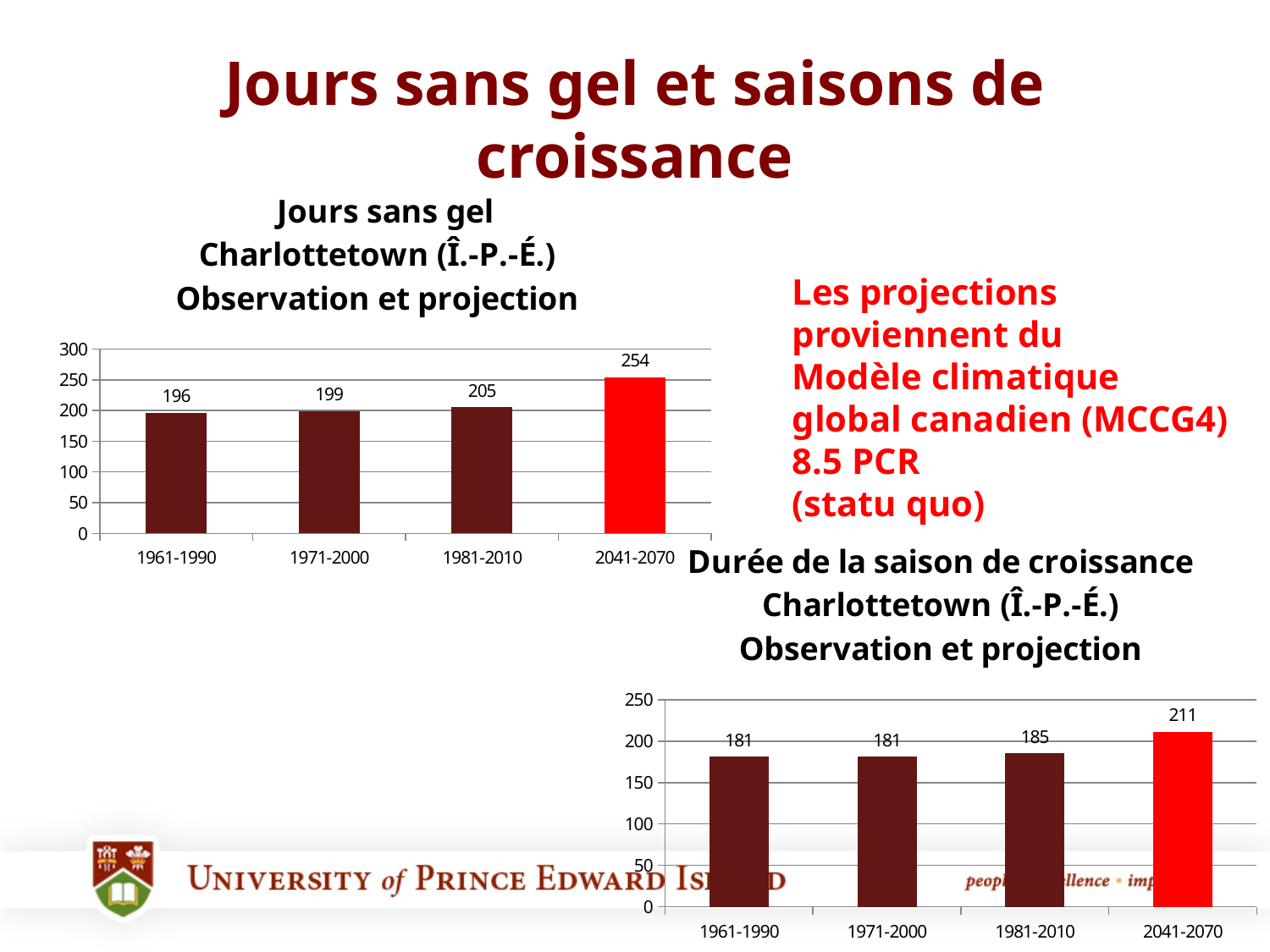
In the 'Jours sans gel' chart, which period has the highest value? 2041-2070 In the 'Durée de la saison de croissance' chart, what is the value for 2041-2070? 211 In the 'Durée de la saison de croissance' chart, what is the difference between the values for 2041-2070 and 1981-2010? 26 In the 'Durée de la saison de croissance' chart, what colour is the bar for 2041-2070? red What kind of chart is the 'Jours sans gel' chart? bar chart In the 'Durée de la saison de croissance' chart, which period has the highest value? 2041-2070 In the 'Durée de la saison de croissance' chart, do the values rise or fall from 1961-1990 to 2041-2070? rise In the 'Jours sans gel' chart, what is the value for 1981-2010? 205 In the 'Durée de la saison de croissance' chart, what is the value for 1971-2000? 181 In the 'Jours sans gel' chart, how many periods are shown on the x axis? 4 In the 'Jours sans gel' chart, which period has the lowest value? 1961-1990 In the 'Jours sans gel' chart, what is the difference between the values for 2041-2070 and 1961-1990? 58